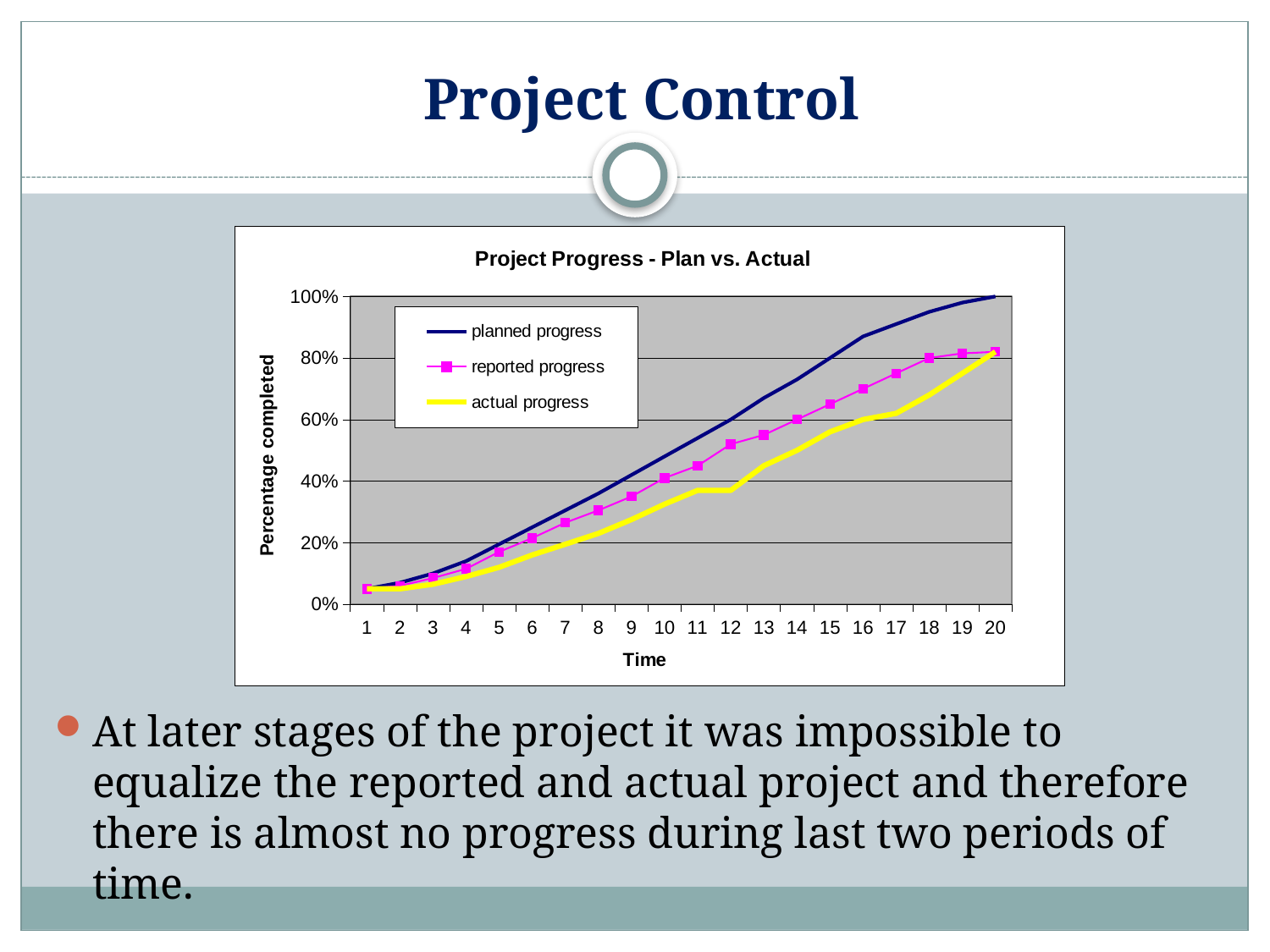
How many series does the legend list? 3 Which series has the highest value at time 20? planned progress What is the value of planned progress at time 20? 100% Is the value for reported progress at time 15 greater or less than 60%? greater What is the label of the y axis? Percentage completed What is the title of the chart? Project Progress - Plan vs. Actual Is the value for actual progress at time 10 greater or less than 40%? less At time 14, which is larger: planned progress or actual progress? planned progress Do the planned progress values rise or fall as time increases? rise Is the value for planned progress at time 16 greater or less than 80%? greater How many time periods are shown on the x axis? 20 What kind of chart is shown on the slide? line chart